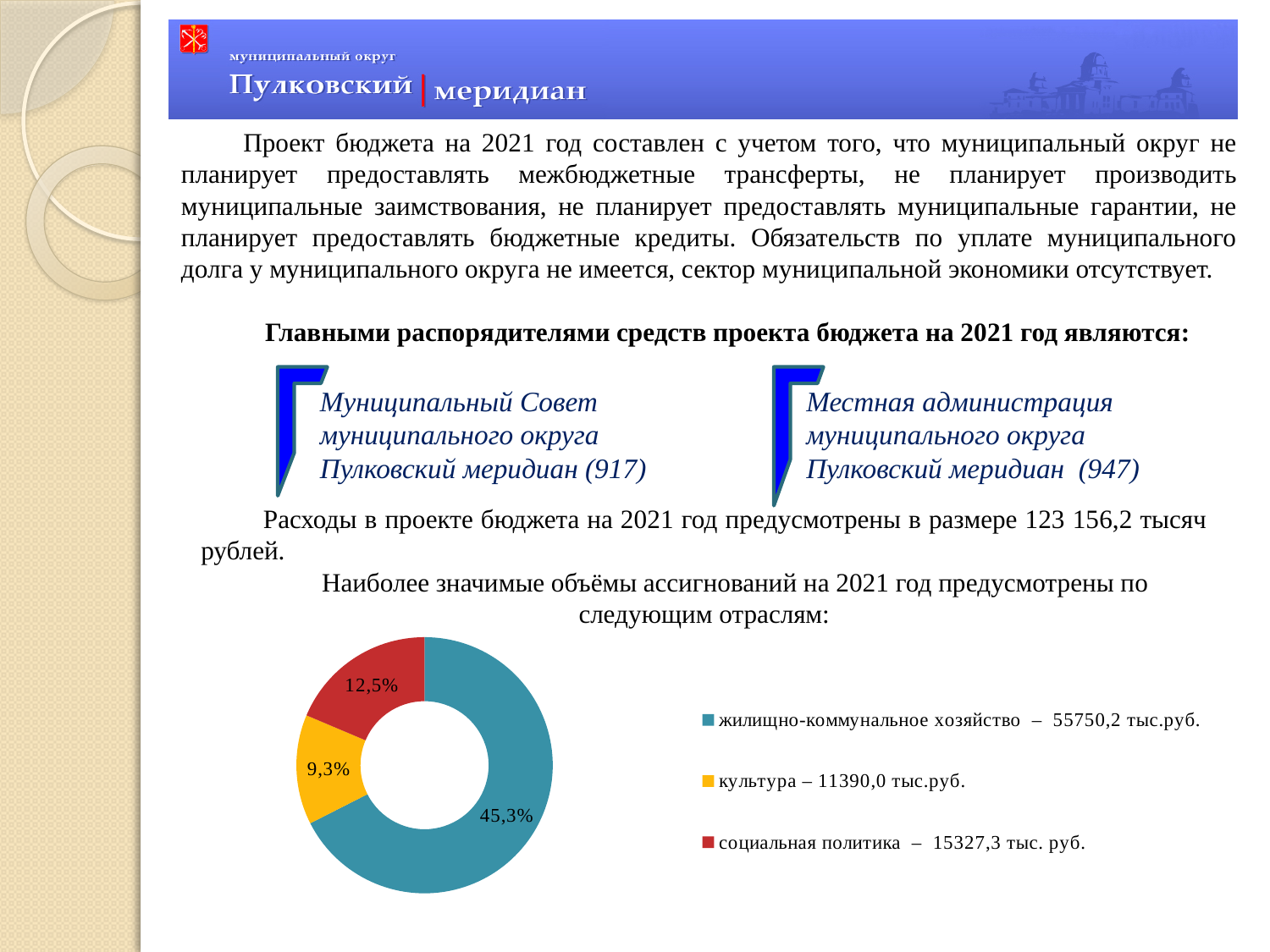
What amount in тыс.руб. does the legend give for культура? 11390,0 тыс.руб. What is the difference in percentage points between the социальная политика slice and the культура slice? 3,2 What percentage is shown for the социальная политика slice? 12,5% What is the difference in percentage points between the жилищно-коммунальное хозяйство slice and the социальная политика slice? 32,8 How many slices does the chart have? 3 What percentage is shown for the культура slice? 9,3% Which slice is larger: социальная политика or культура? социальная политика Which category has the smallest slice in the chart? культура What kind of chart is shown on the slide? doughnut chart How many entries does the chart legend list? 3 Which category has the largest slice in the chart? жилищно-коммунальное хозяйство What percentage share does the slice for жилищно-коммунальное хозяйство have in the chart? 45,3%